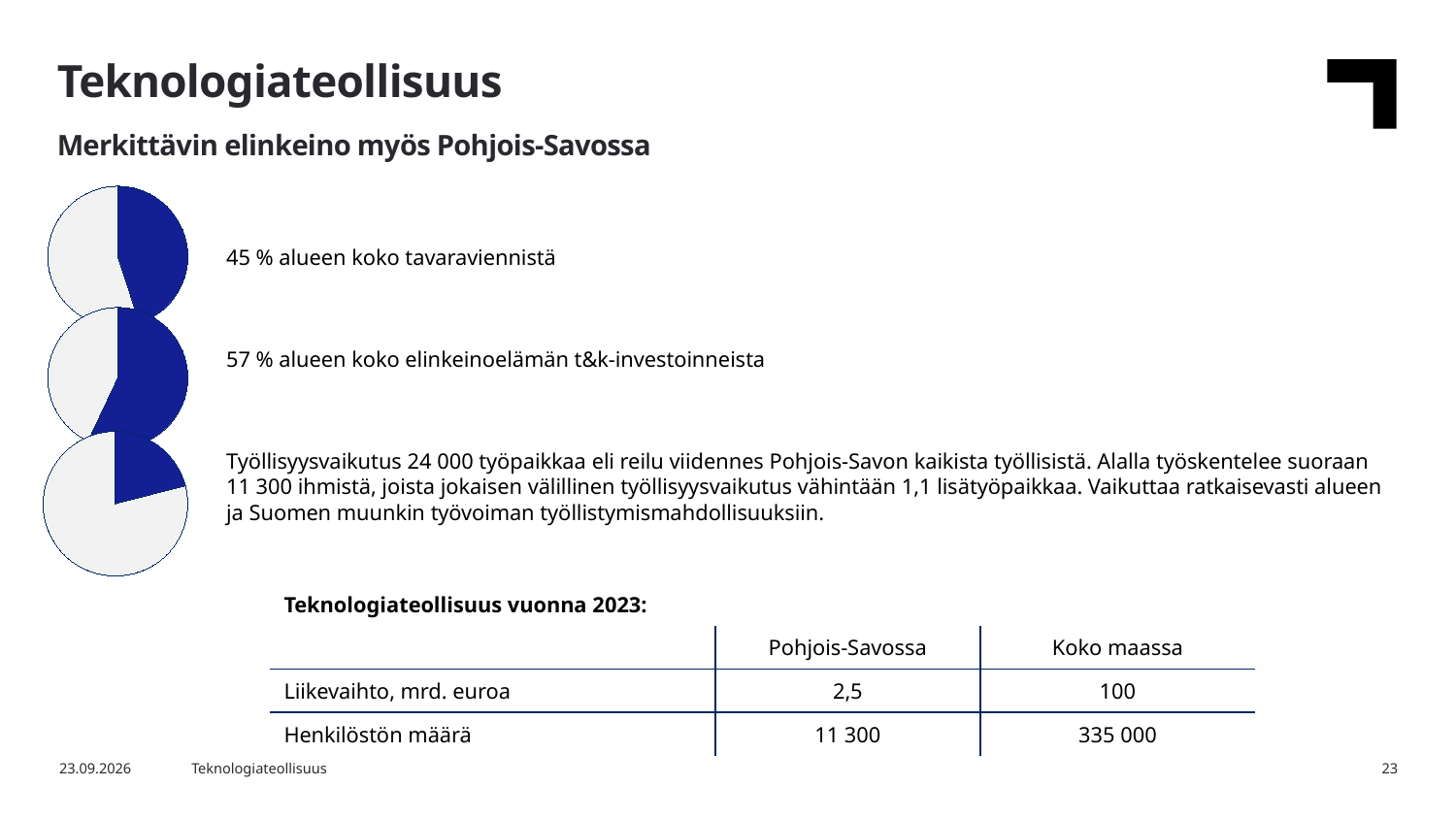
What does the top pie chart represent according to the text next to it? 45 % alueen koko tavaraviennistä How many pie charts are on the slide? 3 What colour is used for the highlighted slice in each pie chart? Blue What is the difference in percentage points between the share shown by the middle pie chart and the share shown by the top pie chart? 12 percentage points Is the blue slice in the middle pie chart greater or less than 50% of the pie? greater In the middle pie chart, what share of the region's business R&D investments does the blue slice represent? 57 % Which pie chart has the smallest blue slice: the top, middle or bottom one? Bottom In the top pie chart, what share of the region's total goods exports does the blue slice represent? 45 % Which pie chart has the largest blue slice: the top, middle or bottom one? Middle Is the blue slice in the bottom pie chart greater or less than 50% of the pie? less What kind of charts are shown on the left side of the slide? Pie charts Which is larger: the blue share in the top pie chart (goods exports) or in the middle pie chart (R&D investments)? Middle pie chart (R&D investments)